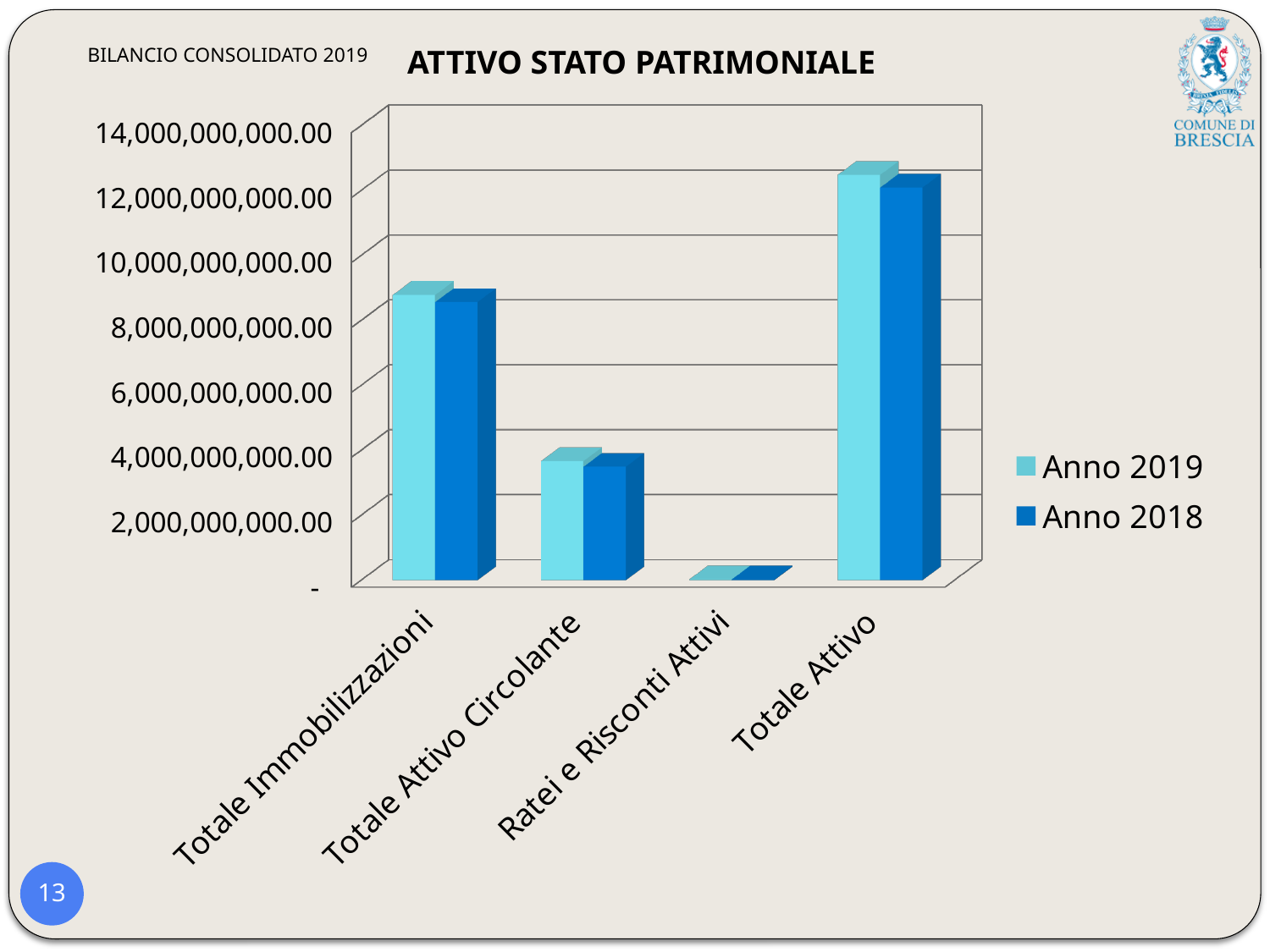
Which category has the lowest value for Anno 2018? Ratei e Risconti Attivi Is the Anno 2019 value for Totale Attivo greater or less than 12,000,000,000.00? greater Which two series are listed in the legend? Anno 2019 and Anno 2018 What is the title of the chart? ATTIVO STATO PATRIMONIALE Is the Anno 2019 value for Totale Immobilizzazioni greater or less than 8,000,000,000.00? greater Is the Anno 2019 value for Ratei e Risconti Attivi greater or less than 2,000,000,000.00? less What kind of chart is shown on the slide? bar chart How many categories are shown on the x axis? 4 Which category has the highest value for Anno 2019? Totale Attivo For Anno 2019, which is larger: Totale Immobilizzazioni or Totale Attivo Circolante? Totale Immobilizzazioni How many series does the legend list? 2